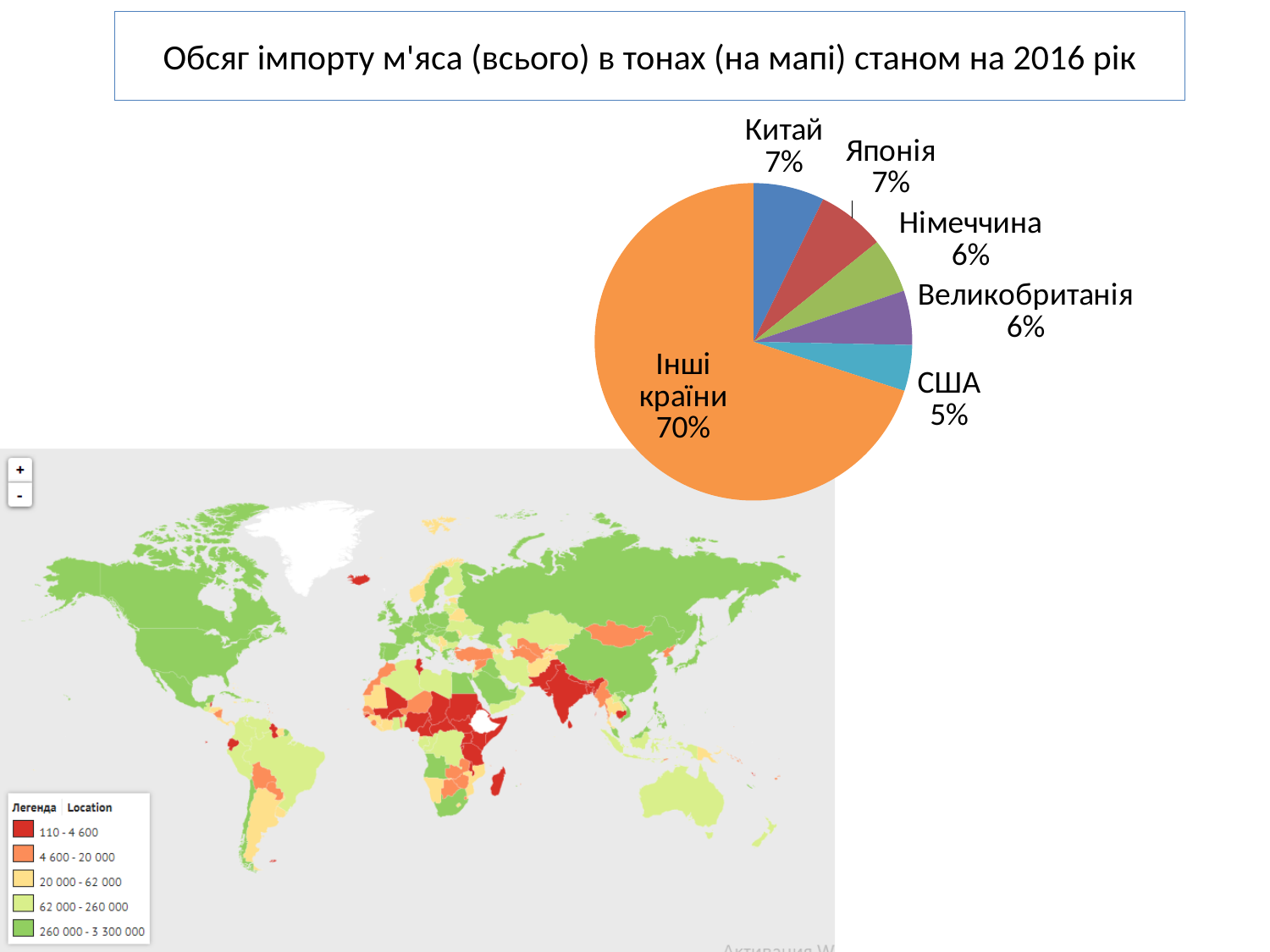
What kind of chart is shown on the slide? pie chart Which named country has the smallest slice in the pie chart? США How many slices does the pie chart have? 6 What is the difference between the share of Інші країни and the share of Китай in the pie chart? 63% What share of the pie chart does Інші країни (Other countries) hold? 70% What share of the pie chart does Німеччина (Germany) hold? 6% What share of the pie chart does США (USA) hold? 5% What is the title of the slide containing the pie chart? Обсяг імпорту м'яса (всього) в тонах (на мапі) станом на 2016 рік Which slice of the pie chart is the largest? Інші країни